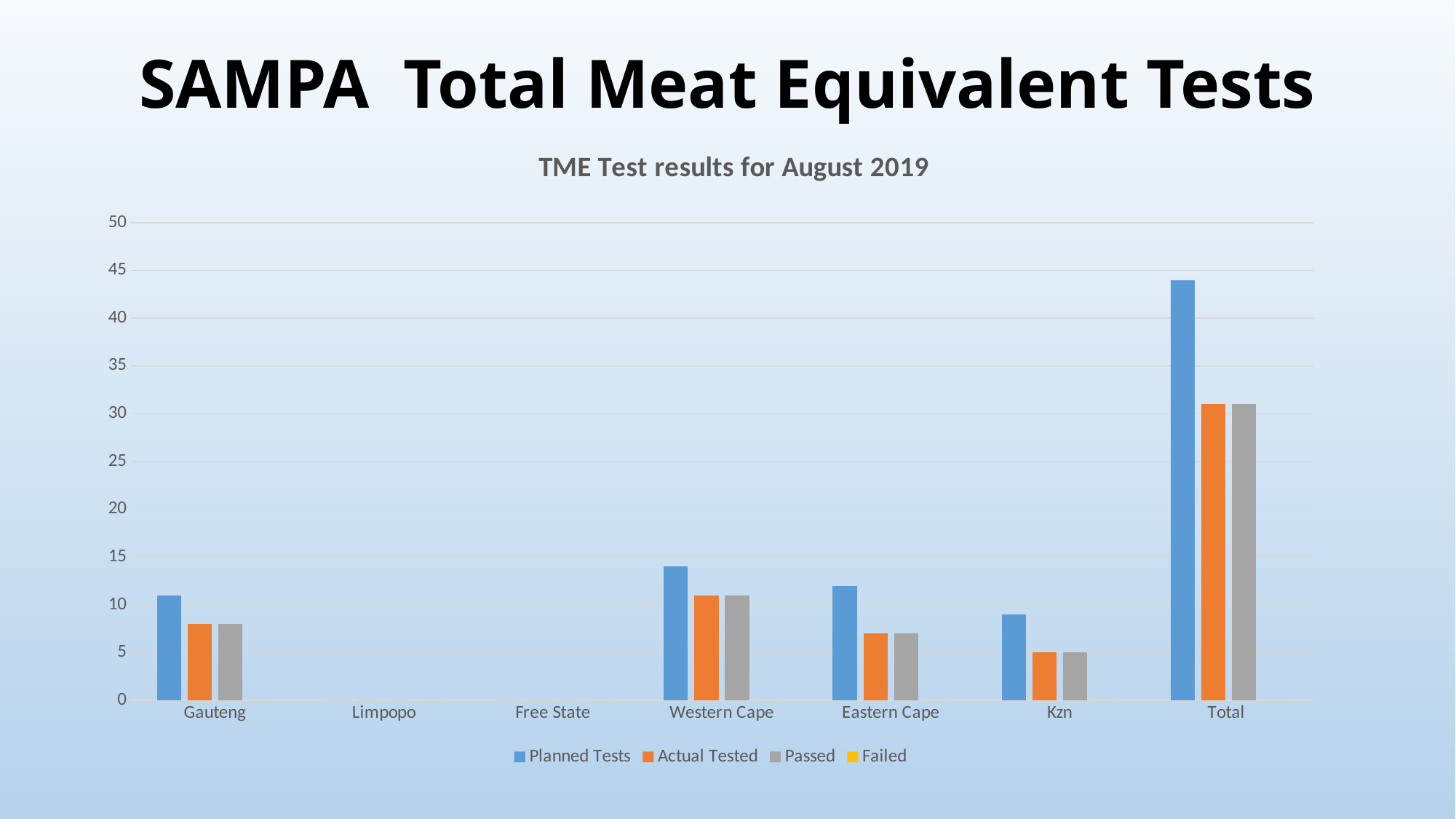
Which category has the highest Planned Tests value? Total How many series does the legend list? 4 How many categories are shown on the x axis? 7 Among the provinces (excluding Total), which has the highest Planned Tests value? Western Cape Which series is shown in orange in the legend? Actual Tested Is the Actual Tested value for Total greater or less than 35? less Which is larger for Western Cape: Planned Tests or Actual Tested? Planned Tests Is the Planned Tests value for Gauteng greater or less than 10? greater Is the Planned Tests value for Total greater or less than 40? greater What is the title of the chart? TME Test results for August 2019 What kind of chart is shown on the slide? bar chart